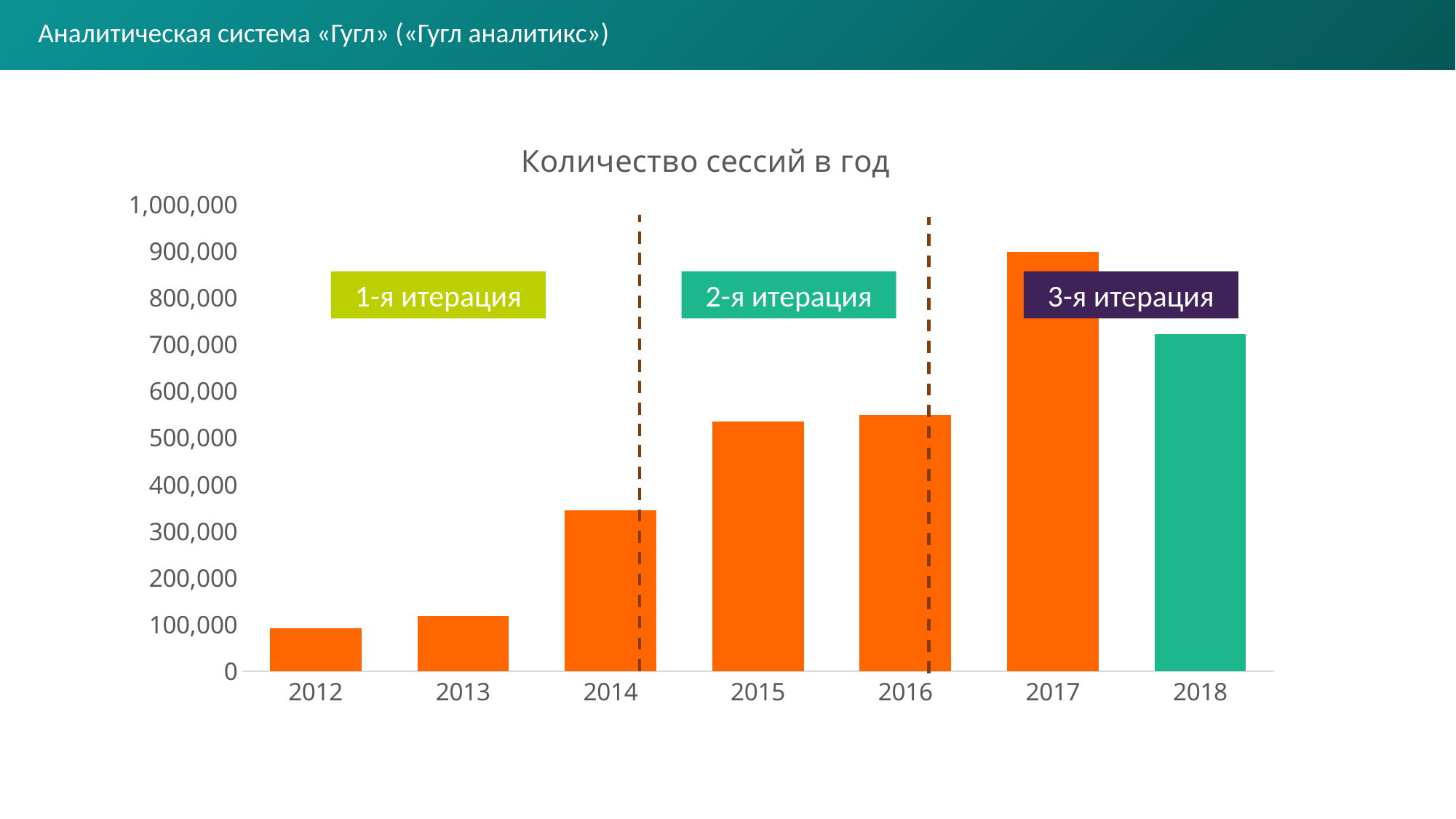
Is the value for 2018 greater or less than 700,000? greater What kind of chart is shown on the slide? Bar chart Which year has the highest number of sessions? 2017 What is the title of the chart? Количество сессий в год Is the value for 2014 greater or less than 300,000? greater Is the value for 2015 greater or less than 600,000? less How many iteration labels (итерация) are shown on the chart? 3 Do the values rise or fall from 2012 to 2017? Rise Which year has more sessions, 2017 or 2018? 2017 How many years are shown on the x axis of the chart? 7 Which year has the lowest number of sessions? 2012